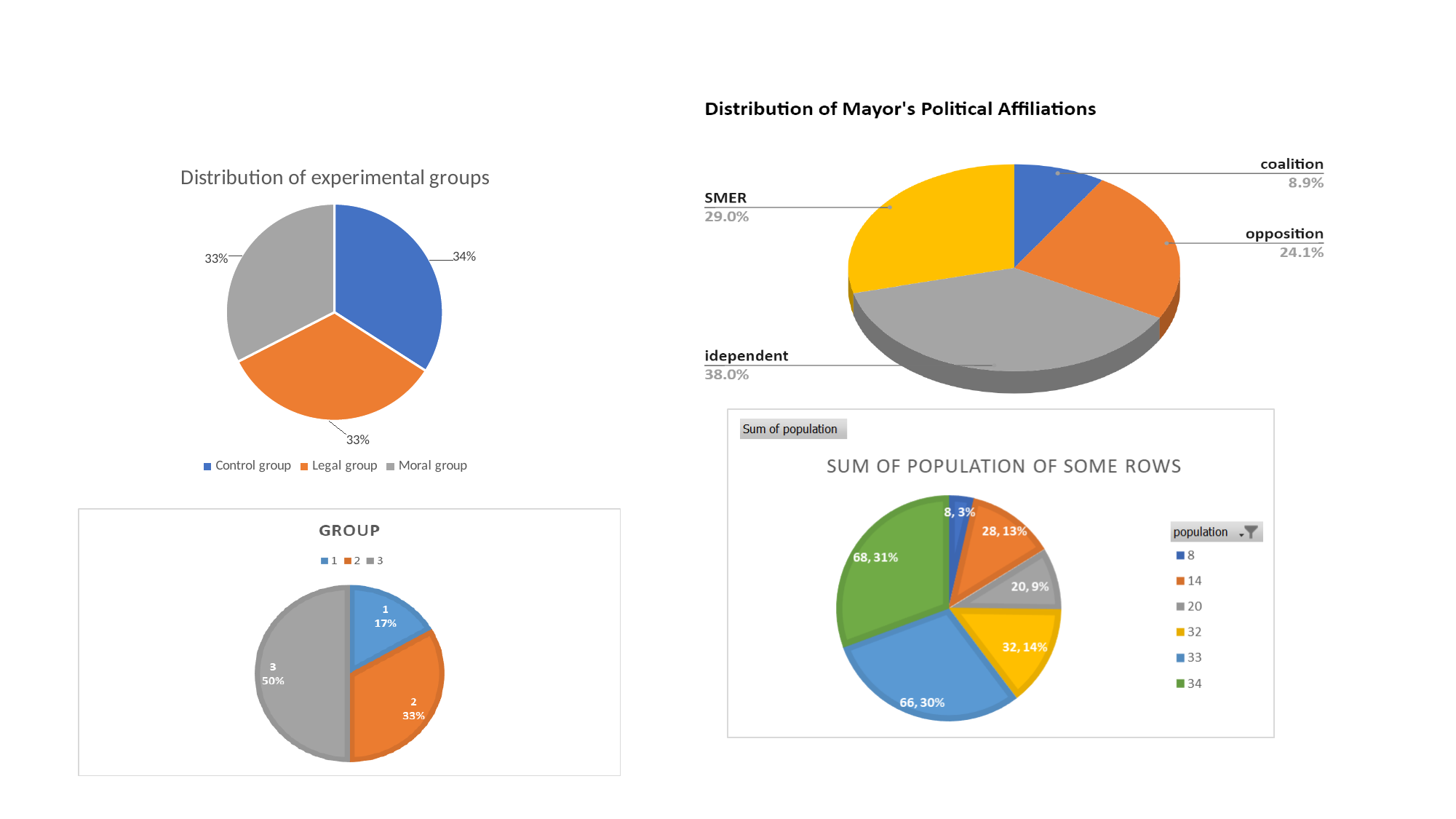
In the 'SUM OF POPULATION OF SOME ROWS' chart, what is the value for the slice labelled 33? 66 In the 'GROUP' chart, what is the difference in percentage points between category 3 and category 1? 33 What kind of chart is the 'GROUP' chart? pie chart In the 'Distribution of experimental groups' chart, what share does the Control group have? 34% In the 'GROUP' chart, what share does category 3 have? 50% In the 'GROUP' chart, which category has the smallest share? 1 In the 'Distribution of Mayor's Political Affiliations' chart, which is larger, opposition or coalition? opposition In the 'SUM OF POPULATION OF SOME ROWS' chart, how many slices does the pie have? 6 In the 'Distribution of experimental groups' chart, how many groups does the legend list? 3 In the 'Distribution of Mayor's Political Affiliations' chart, which affiliation has the largest share? idependent In the 'Distribution of Mayor's Political Affiliations' chart, what share does SMER have? 29.0% In the 'SUM OF POPULATION OF SOME ROWS' chart, which slice has the largest share? 34